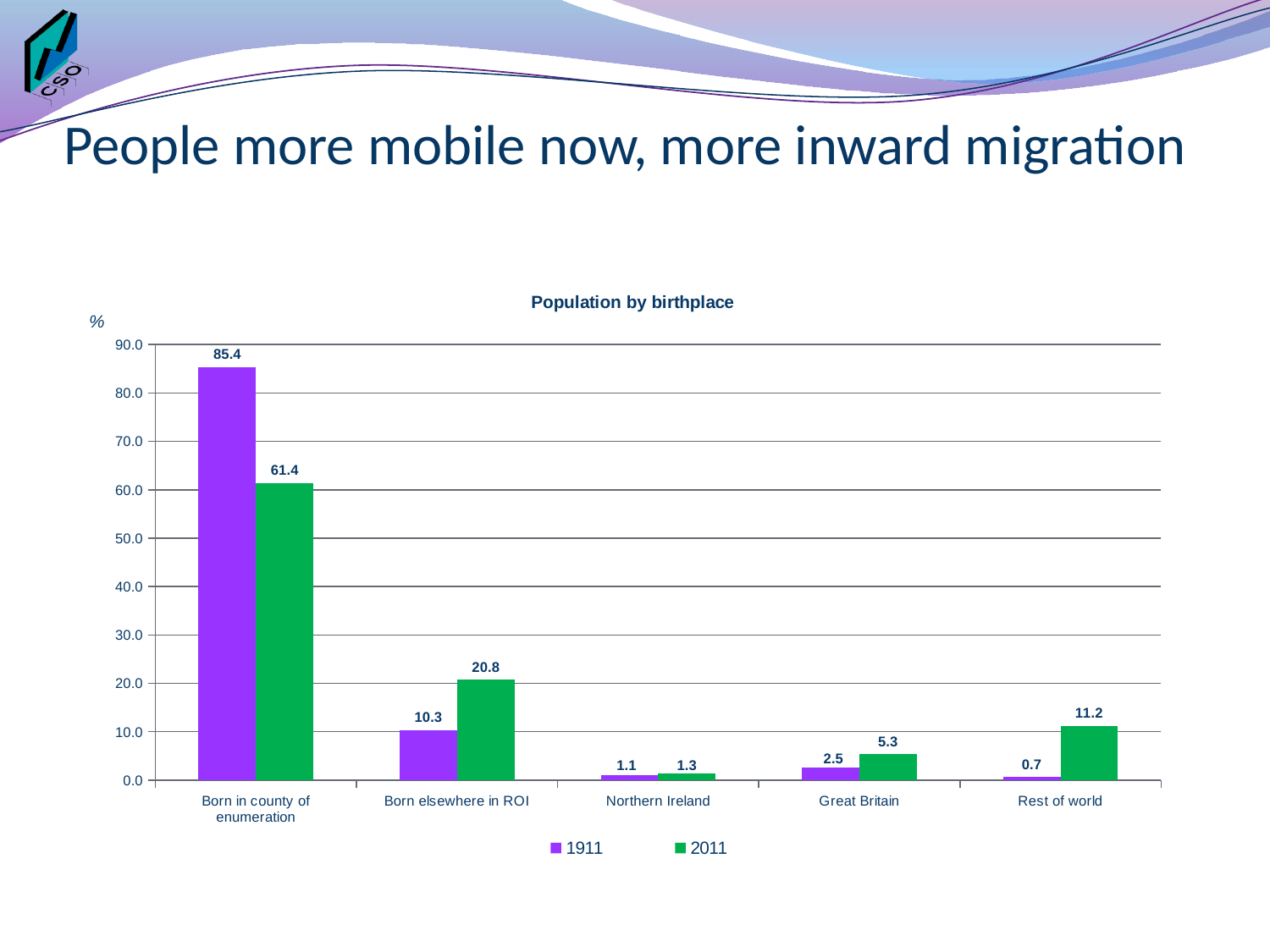
What type of chart is shown? Bar chart Which is larger for Northern Ireland, the 1911 value or the 2011 value? 2011 What is the difference between the 2011 and 1911 values for Great Britain? 2.8 What is the 1911 value for Born in county of enumeration? 85.4 What is the difference between the 1911 and 2011 values for Born in county of enumeration? 24.0 How many birthplace categories are shown on the x axis? 5 What is the 2011 value for Born elsewhere in ROI? 20.8 Is the 2011 value for Born in county of enumeration greater or less than 70.0? less Which category has the highest 2011 value? Born in county of enumeration Which category has the lowest 1911 value? Rest of world How many series does the legend list? 2 What is the 2011 value for Rest of world? 11.2